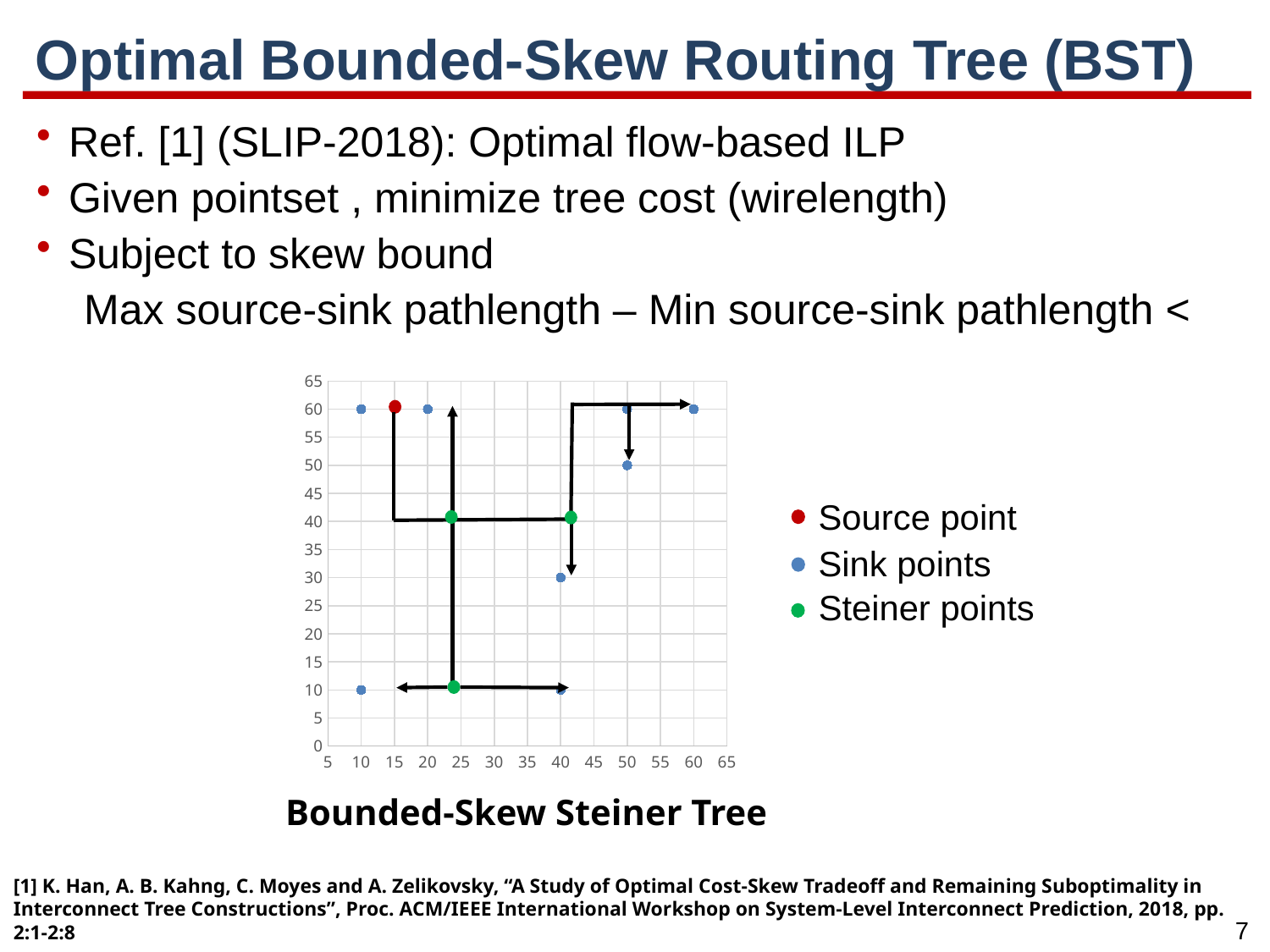
What is the x value of the sink point located at y = 50? 50 What is the y value of the source point? 60 How many series does the legend of the chart list? 3 What is the title shown below the chart? Bounded-Skew Steiner Tree Which has the larger y value: the sink point at (50, 50) or the sink point at (40, 30)? (50, 50) Is the y value of the source point greater or less than 50? greater What is the lowest y value among the sink points? 10 How many Steiner points are plotted in the chart? 3 What are the coordinates of the source point in the chart? (15, 60) What kind of chart is shown on the slide? scatter chart What is the x value of the sink point located at y = 30? 40 Is the x value of the rightmost sink point greater or less than 55? greater